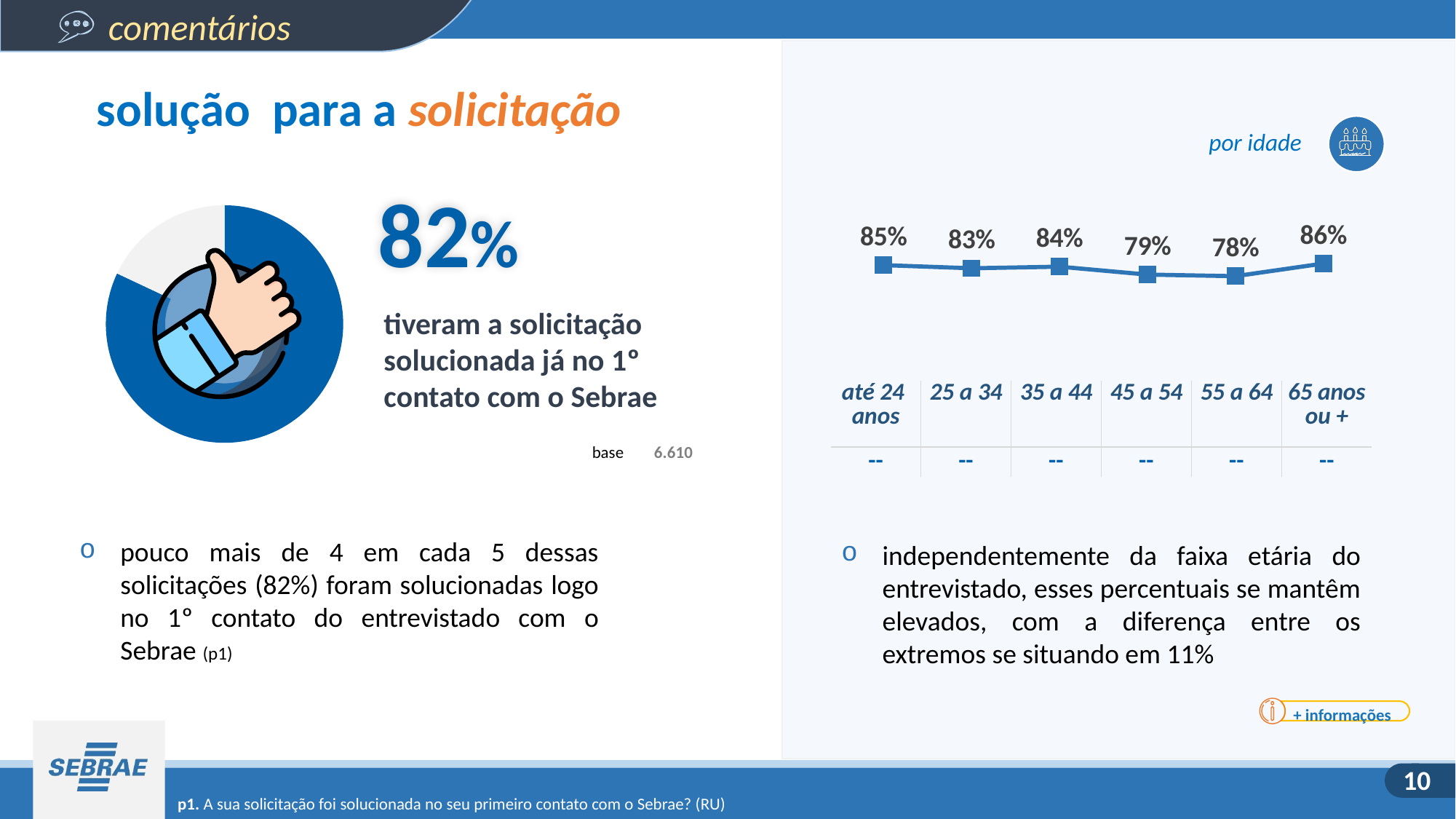
In the 'por idade' chart, which is larger: the value for '25 a 34' or the value for '35 a 44'? 35 a 44 In the 'por idade' chart, what is the value for the 'até 24 anos' age group? 85% In the 'por idade' chart, what is the value for the '65 anos ou +' age group? 86% In the 'por idade' chart, does the value rise or fall from '35 a 44' to '55 a 64'? fall In the 'por idade' chart, which age group has the lowest value? 55 a 64 How many age groups are plotted in the 'por idade' chart? 6 What kind of chart is the 'por idade' chart? line chart In the 'por idade' chart, which age group has the highest value? 65 anos ou + In the 'por idade' chart, what is the difference between the values for '65 anos ou +' and '55 a 64'? 8% In the 'por idade' chart, what is the value for the '45 a 54' age group? 79% What kind of chart is shown on the left of the slide, behind the thumbs-up icon? doughnut chart What percentage is shown next to the pie chart on the left of the slide? 82%